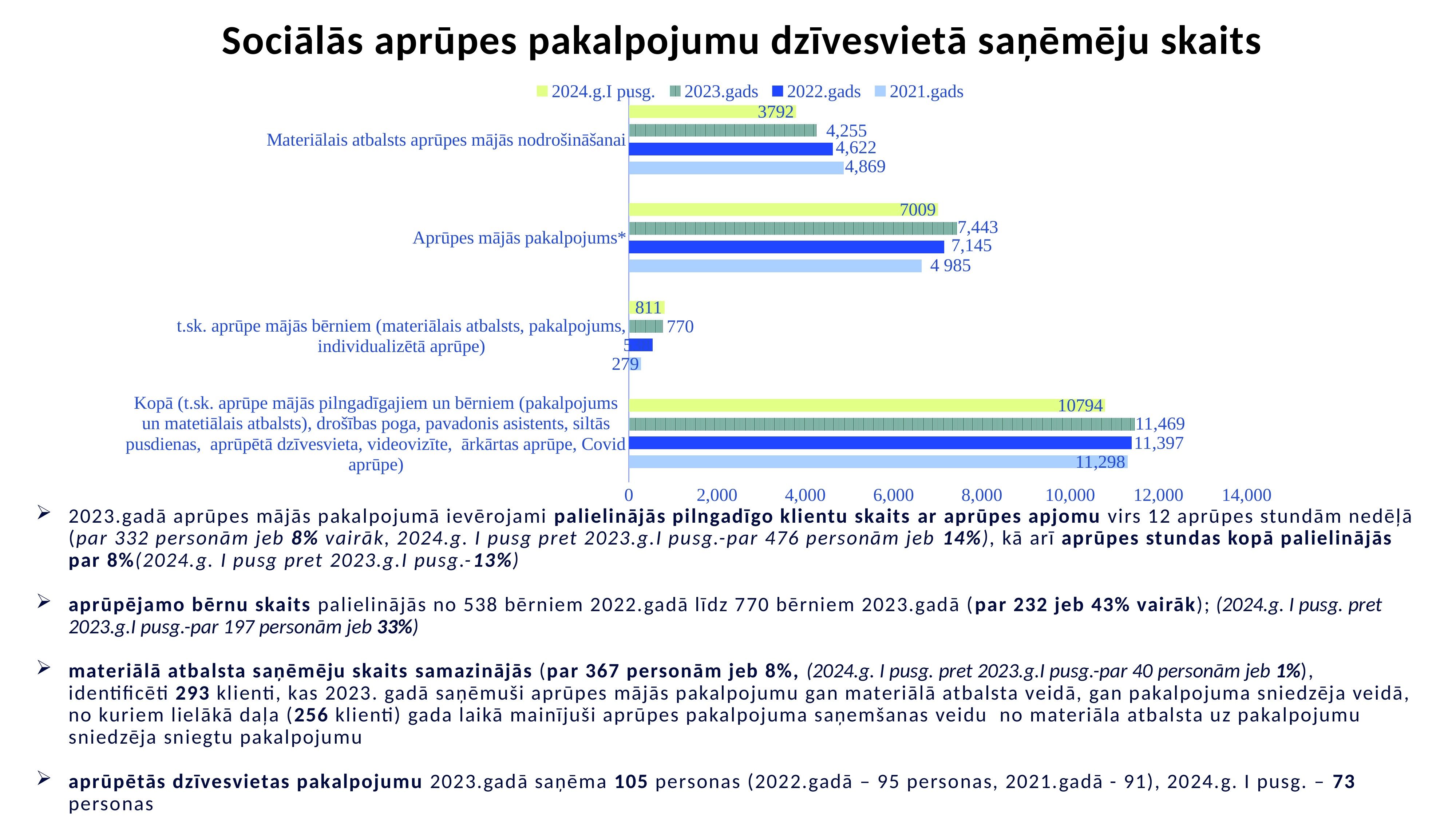
What is the 2023.gads value for "Aprūpes mājās pakalpojums*"? 7,443 What is the difference between the 2023.gads and 2022.gads values for "Materiālais atbalsts aprūpes mājās nodrošināšanai"? 367 What is the 2021.gads value for "Materiālais atbalsts aprūpes mājās nodrošināšanai"? 4,869 What kind of chart is shown on the slide? bar chart Which is larger for "t.sk. aprūpe mājās bērniem": the 2024.g.I pusg. value or the 2023.gads value? 2024.g.I pusg. Which year has the lowest value for "Aprūpes mājās pakalpojums*"? 2021.gads How many series does the chart legend list? 4 What is the 2024.g.I pusg. value for the "Kopā" category? 10794 Is the 2022.gads value for "t.sk. aprūpe mājās bērniem" greater or less than 2,000? less Which year has the highest value for "Materiālais atbalsts aprūpes mājās nodrošināšanai"? 2021.gads How many categories are plotted on the chart? 4 What is the title of the chart? Sociālās aprūpes pakalpojumu dzīvesvietā saņēmēju skaits